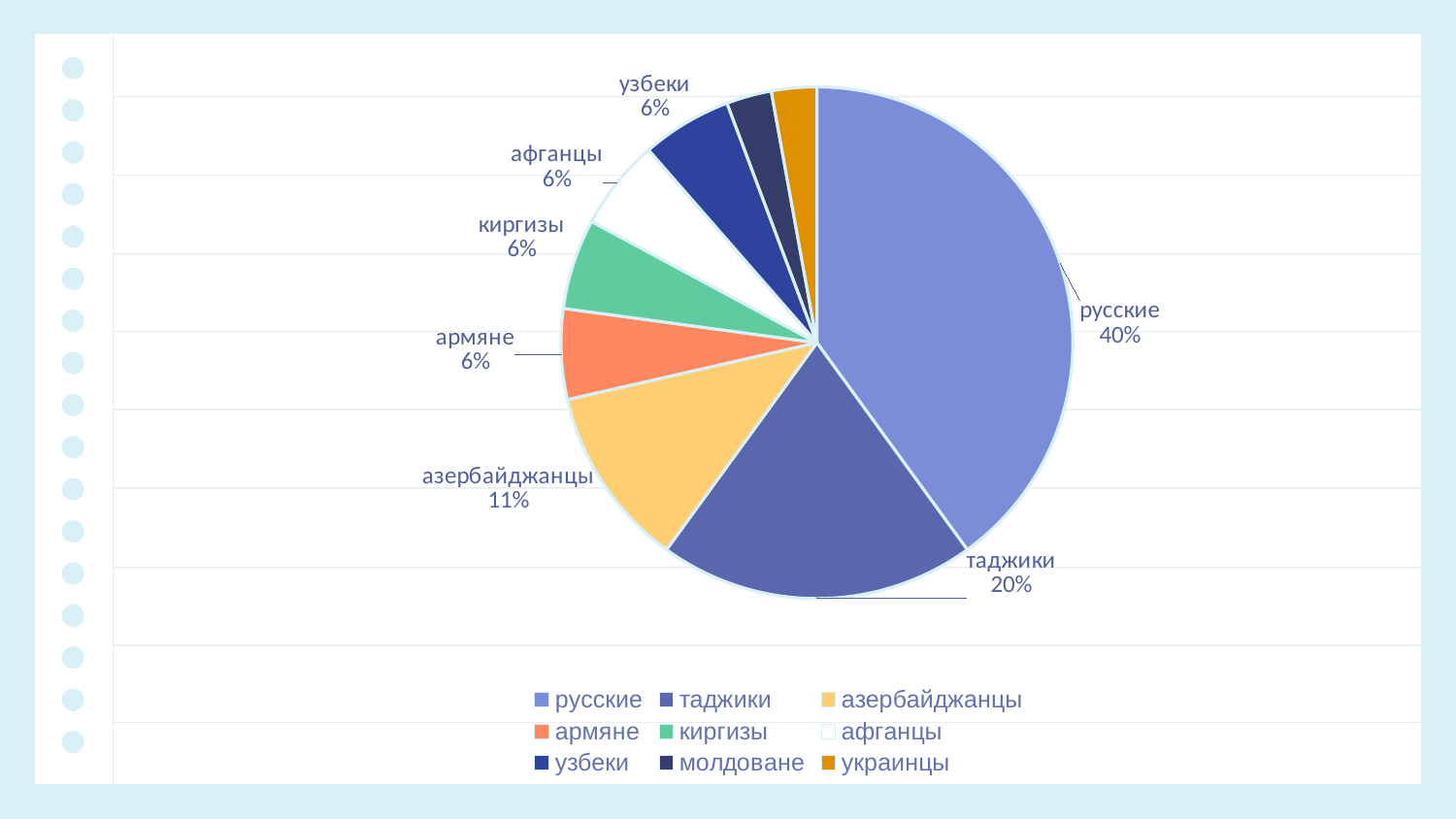
What is the value shown for таджики? 20% Which category has the largest slice of the pie? русские What is the difference in percentage points between азербайджанцы and киргизы? 5 Which is larger, the slice for таджики or the slice for азербайджанцы? таджики What is the difference in percentage points between русские and таджики? 20 What kind of chart is shown on the slide? pie chart What is the value shown for армяне? 6% What share of the pie does русские hold? 40% What is the value shown for азербайджанцы? 11% How many categories does the legend list? 9 What is the value shown for узбеки? 6% Which category is shown in orange in the legend? украинцы